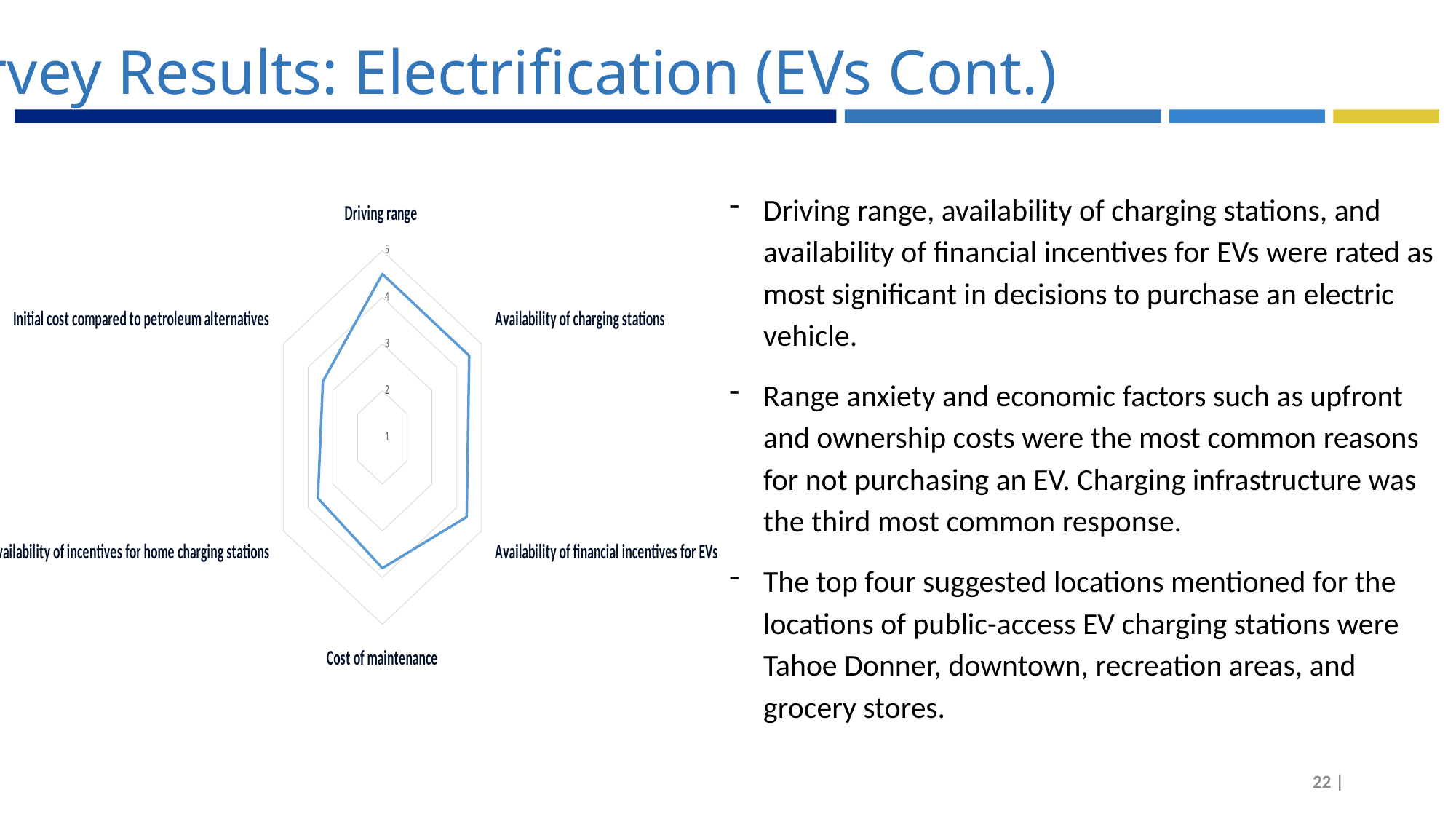
Is the value for Cost of maintenance greater or less than 2? greater Is the value for Initial cost compared to petroleum alternatives greater or less than 4? less How many categories (axes) does the radar chart have? 6 Which category label appears at the top of the radar chart? Driving range Which has the larger value, Availability of financial incentives for EVs or Initial cost compared to petroleum alternatives? Availability of financial incentives for EVs Which has the larger value, Availability of charging stations or Availability of incentives for home charging stations? Availability of charging stations Which has the larger value, Driving range or Cost of maintenance? Driving range Is the value for Driving range greater or less than 4? greater What kind of chart is shown on the slide? Radar chart What is the highest value shown on the radar chart's scale? 5